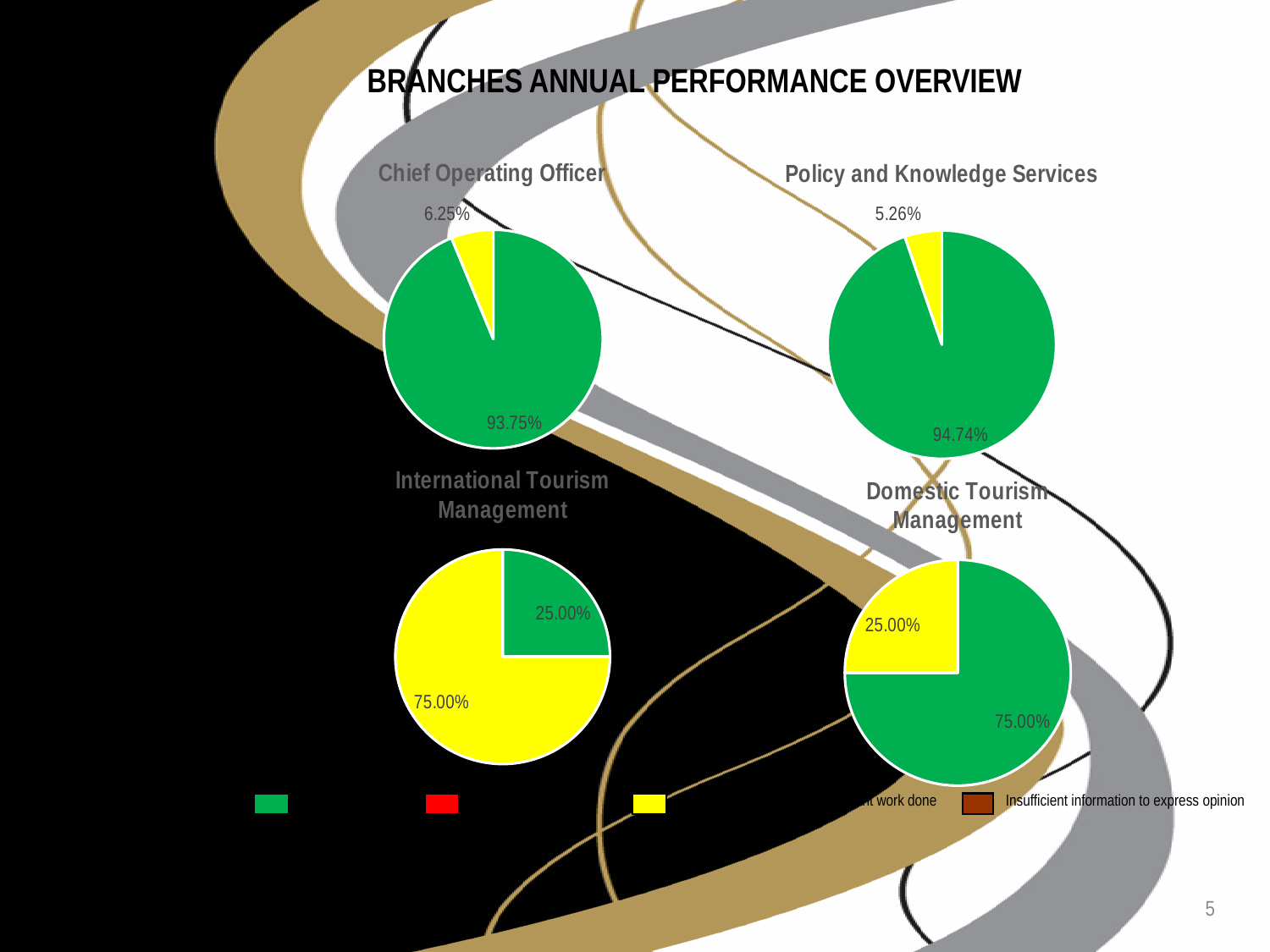
In the Policy and Knowledge Services pie chart, what share does the green slice have? 94.74% In the Policy and Knowledge Services pie chart, what share does the yellow slice have? 5.26% In the Chief Operating Officer pie chart, what share does the green slice have? 93.75% What is the difference between the green slice shares of the Policy and Knowledge Services pie chart and the Chief Operating Officer pie chart? 0.99% In the International Tourism Management pie chart, which slice is larger, the green one or the yellow one? yellow What kind of chart is used for the Chief Operating Officer branch? pie chart How many pie charts are shown on the slide? 4 In the Domestic Tourism Management pie chart, which slice is larger, the green one or the yellow one? green What is the title of the slide containing the pie charts? BRANCHES ANNUAL PERFORMANCE OVERVIEW